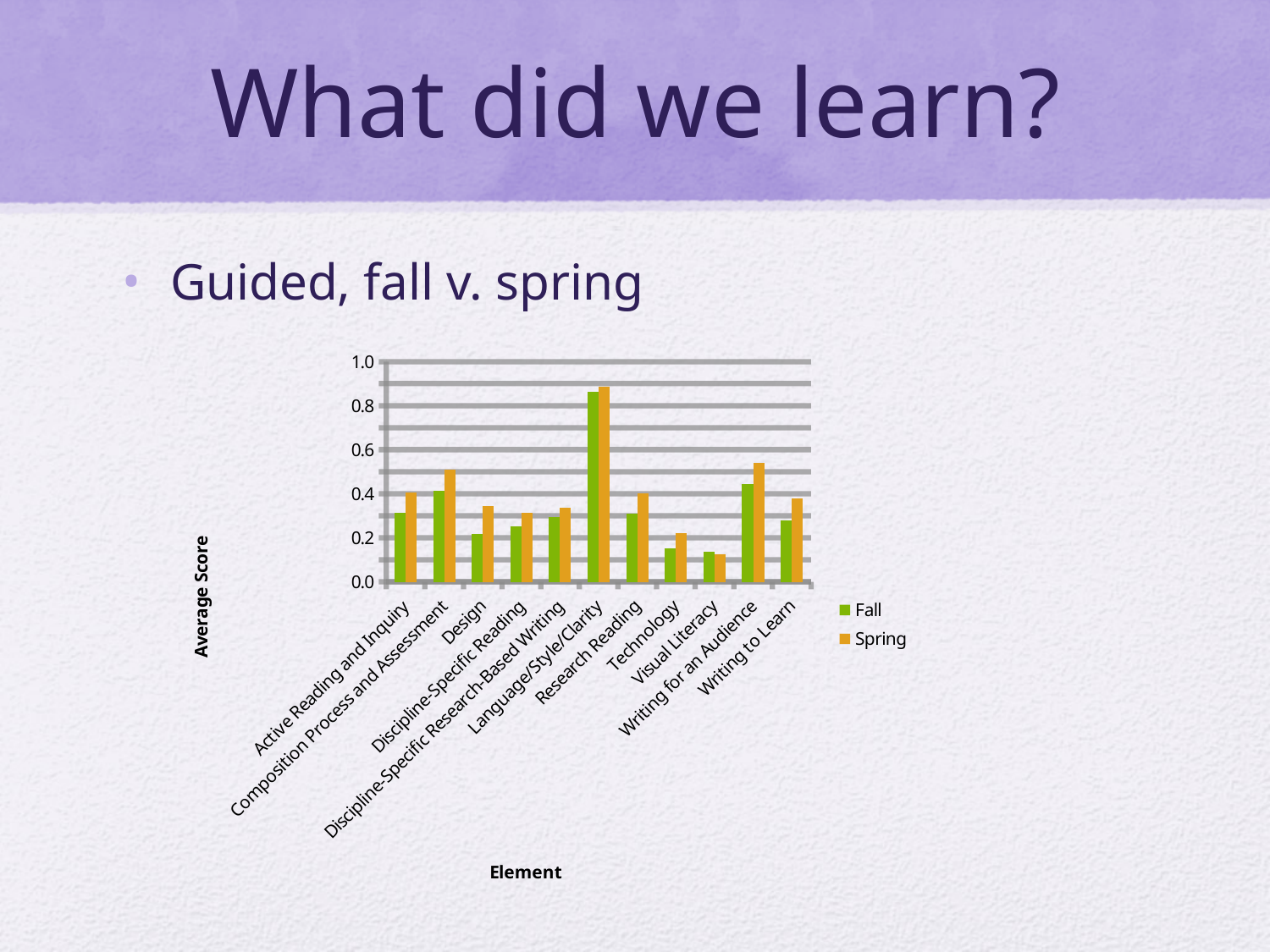
Which element has the highest Spring average score? Language/Style/Clarity Which element has the lowest Spring average score? Visual Literacy Which element has the highest Fall average score? Language/Style/Clarity How many series does the legend list? 2 Is the Fall value for Language/Style/Clarity greater or less than 0.8? greater Is the Spring value for Writing for an Audience greater or less than 0.4? greater What is the title of the vertical axis? Average Score For Writing for an Audience, which is larger, the Fall value or the Spring value? Spring What kind of chart is shown on the slide? Bar chart How many categories (elements) are plotted on the x axis? 11 Is the Spring value for Technology greater or less than 0.4? less For Design, which is larger, the Fall value or the Spring value? Spring